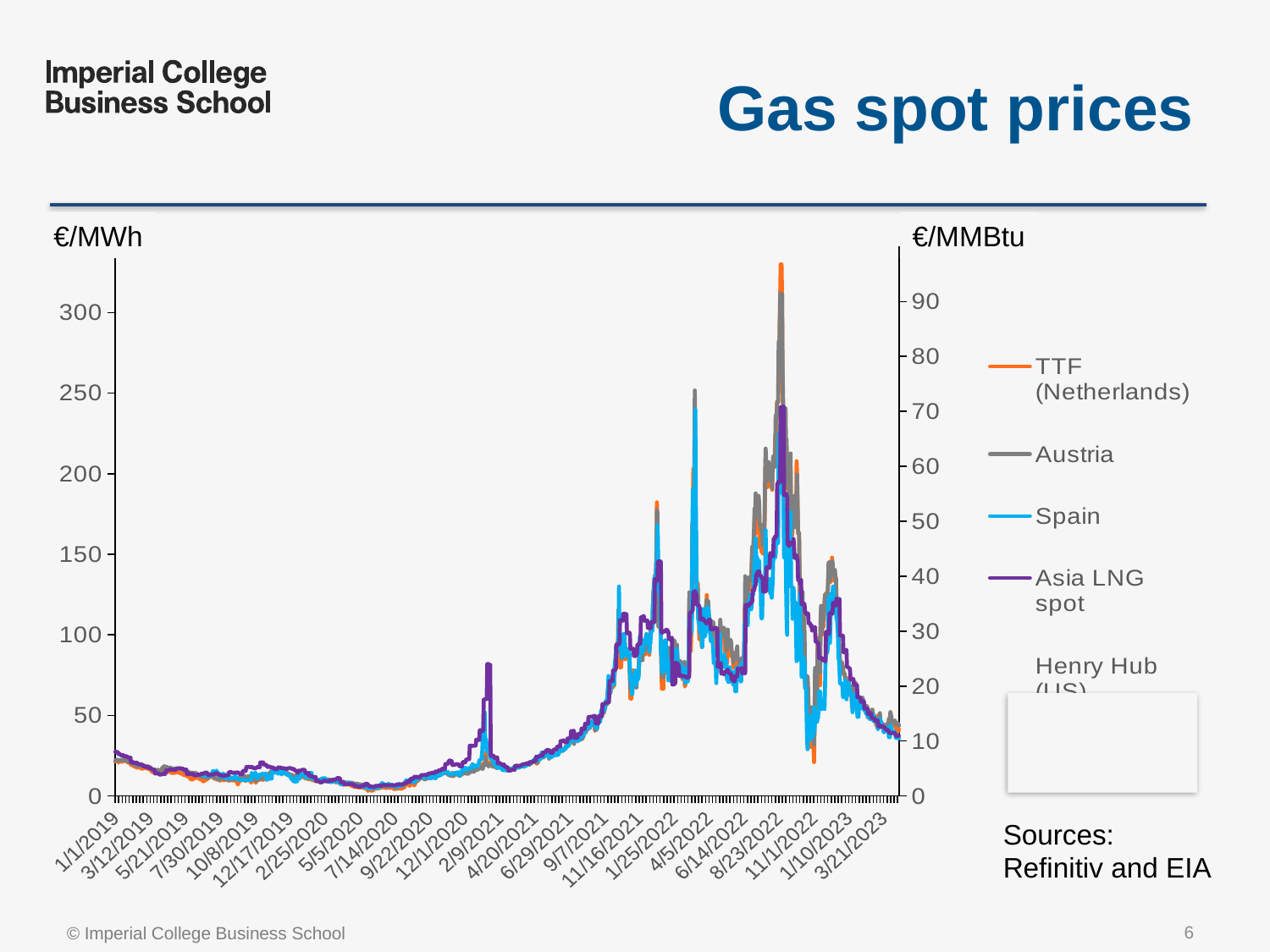
Do the gas spot prices generally rise or fall between 9/22/2020 and 8/23/2022? rise Do the gas spot prices generally rise or fall between 8/23/2022 and 3/21/2023? fall Is the peak value of the TTF (Netherlands) series in 2022 greater or less than 300 €/MWh? greater Is the value of the TTF (Netherlands) series at 1/1/2019 greater or less than 50 €/MWh? less What kind of chart is shown on the slide? line chart What is the title of the chart? Gas spot prices Is the spike of the Asia LNG spot series around 2/9/2021 greater or less than 50 €/MWh? greater What unit is shown on the left vertical axis? €/MWh How many series does the legend list? 5